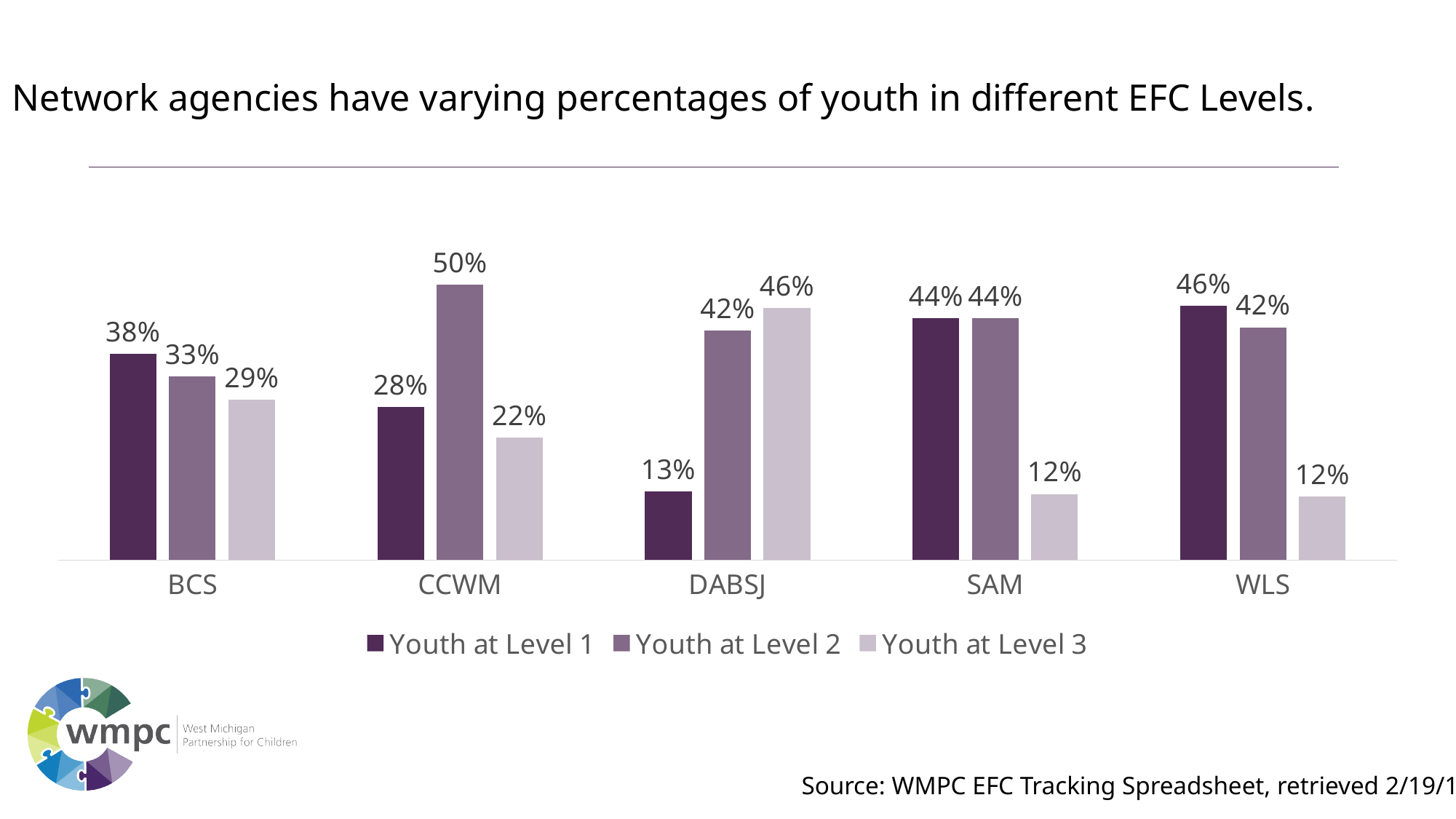
How many series does the legend list? 3 Which agency has the lowest percentage of youth at Level 1? DABSJ Which agency has the highest percentage of youth at Level 3? DABSJ How many agencies are shown on the x axis? 5 Which is larger at BCS: the percentage of youth at Level 1 or at Level 3? Youth at Level 1 What percentage of youth at DABSJ are at Level 3? 46% What percentage of youth at WLS are at Level 3? 12% What is the difference between the Level 2 and Level 1 percentages at CCWM? 22% What kind of chart is shown on the slide? Bar chart What percentage of youth at CCWM are at Level 2? 50% What percentage of youth at BCS are at Level 1? 38% Which agency has the highest percentage of youth at Level 1? WLS